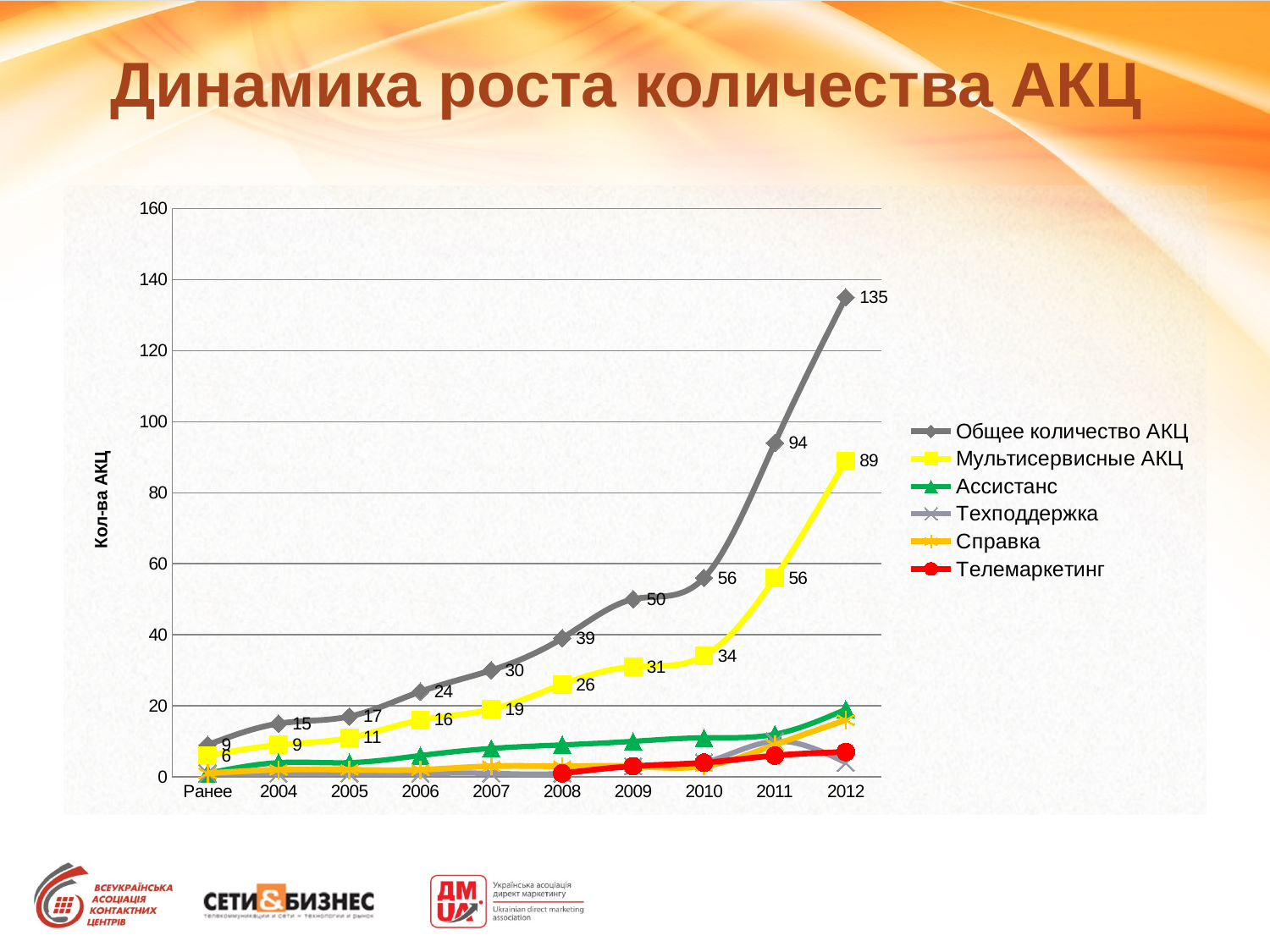
Does Общее количество АКЦ rise or fall from Ранее to 2012? rise What is the difference between Общее количество АКЦ and Мультисервисные АКЦ in 2012? 46 Is the value for Ассистанс in 2012 greater or less than 40? less What is the value of Общее количество АКЦ in 2008? 39 What type of chart is shown on the slide? line chart Which is larger in 2010: Общее количество АКЦ or Мультисервисные АКЦ? Общее количество АКЦ What is the value of Мультисервисные АКЦ in 2011? 56 How many points are plotted along the x axis for each series? 10 How many series does the legend list? 6 What is the difference between Общее количество АКЦ in 2012 and in 2011? 41 What is the value of Общее количество АКЦ in 2012? 135 In which year does Общее количество АКЦ reach its highest value? 2012